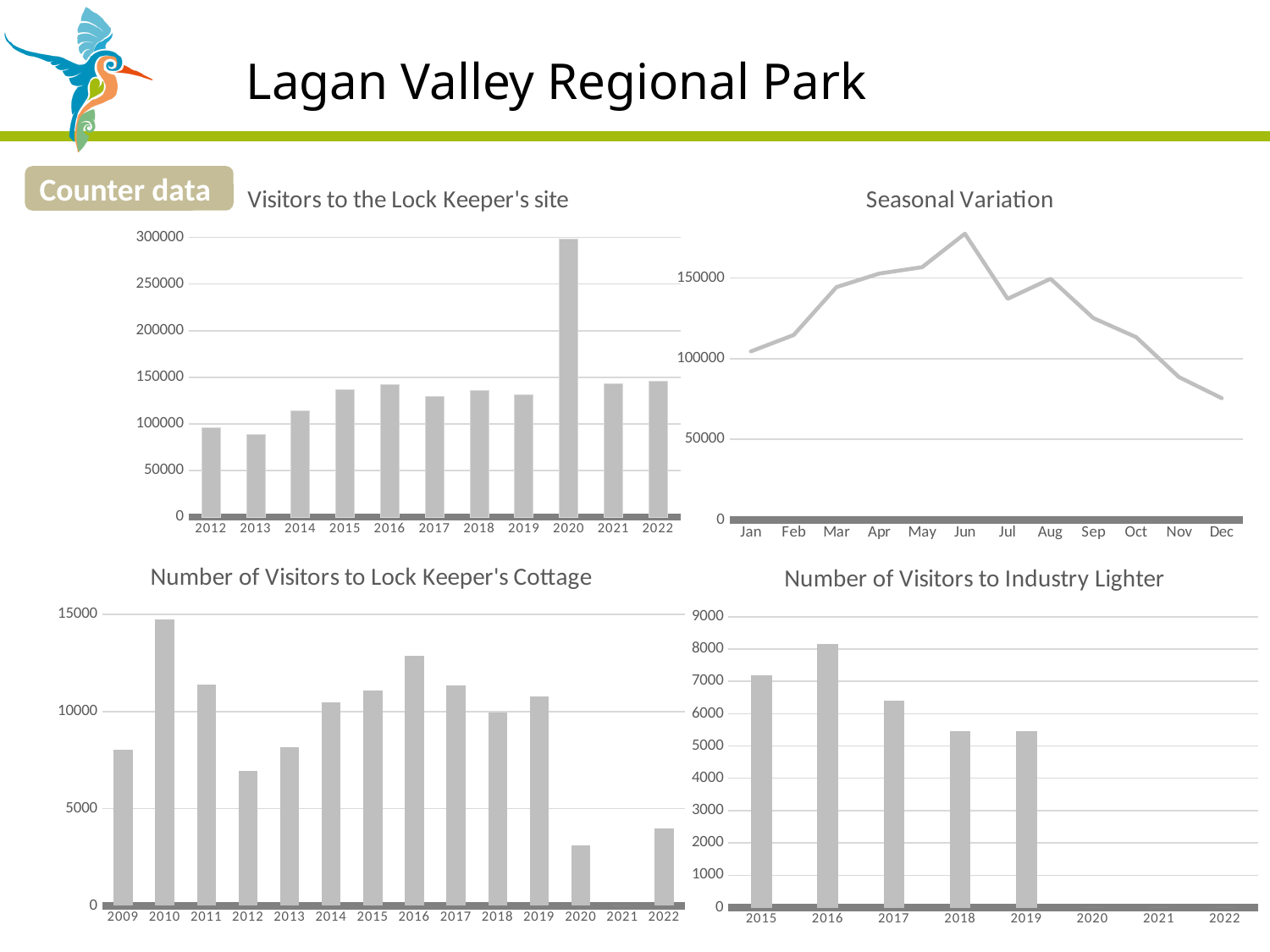
What kind of chart is the 'Seasonal Variation' chart? line chart In the 'Visitors to the Lock Keeper's site' chart, which year has the highest value? 2020 In the 'Number of Visitors to Lock Keeper's Cottage' chart, is the value for 2020 greater or less than 5000? less In the 'Seasonal Variation' chart, which month has the highest value? Jun In the 'Visitors to the Lock Keeper's site' chart, is the value for 2013 greater or less than 100000? less In the 'Number of Visitors to Industry Lighter' chart, which year has the highest value? 2016 In the 'Seasonal Variation' chart, which month has the lowest value? Dec In the 'Visitors to the Lock Keeper's site' chart, which year has the lowest value? 2013 In the 'Seasonal Variation' chart, is the value for Dec greater or less than 100000? less How many years are shown on the x axis of the 'Visitors to the Lock Keeper's site' chart? 11